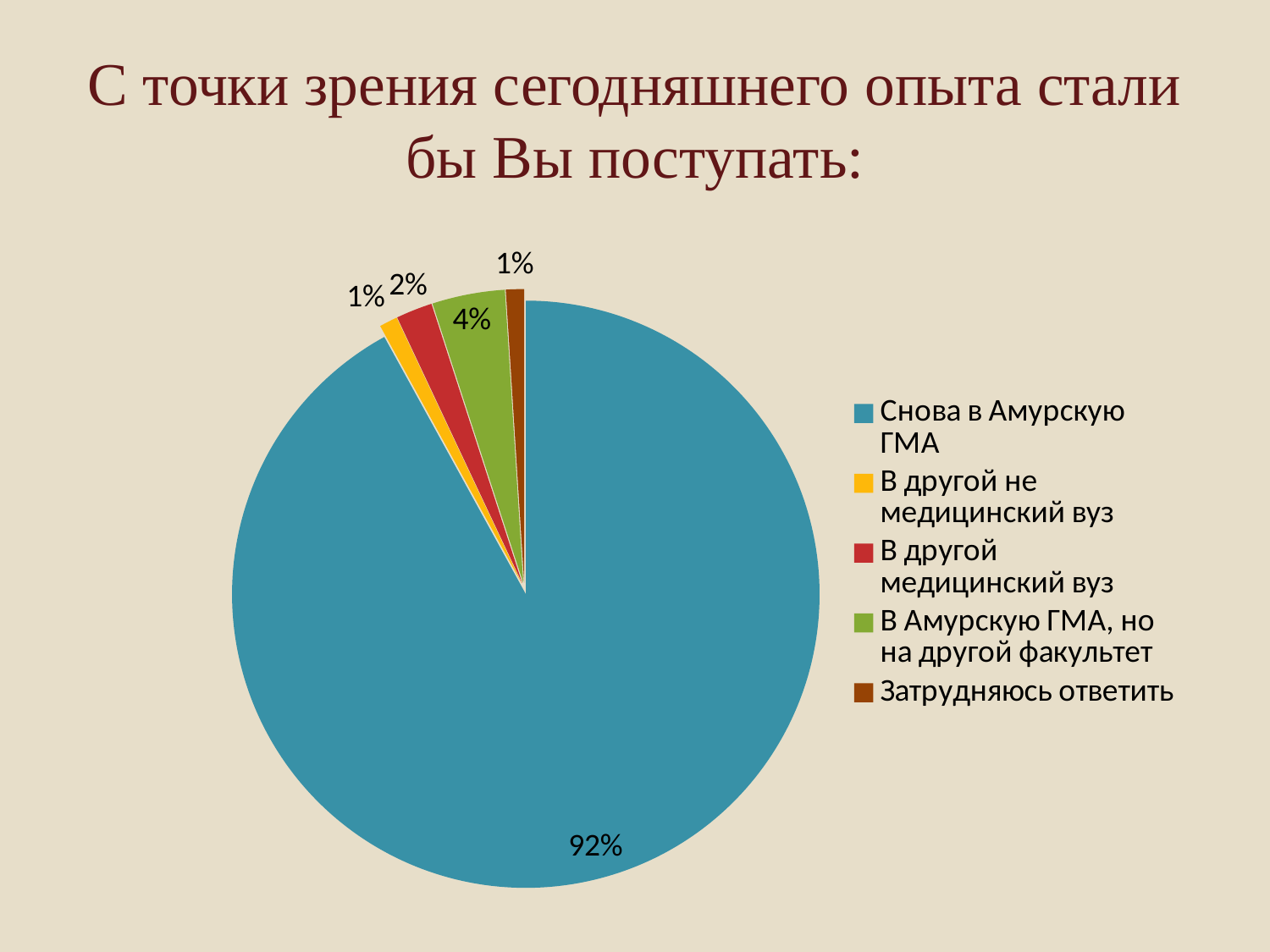
Which category has the largest slice of the pie? Снова в Амурскую ГМА What share of the pie does "Затрудняюсь ответить" have? 1% Which is larger: the share for "В другой медицинский вуз" or the share for "В Амурскую ГМА, но на другой факультет"? В Амурскую ГМА, но на другой факультет What share of the pie does "В другой медицинский вуз" have? 2% What share of the pie does "В Амурскую ГМА, но на другой факультет" have? 4% What is the difference between the shares for "Снова в Амурскую ГМА" and "В Амурскую ГМА, но на другой факультет"? 88% What is the title of the slide containing the pie chart? С точки зрения сегодняшнего опыта стали бы Вы поступать: What colour is the slice for "Снова в Амурскую ГМА"? blue How many categories does the pie chart have? 5 What kind of chart is shown on the slide? pie chart